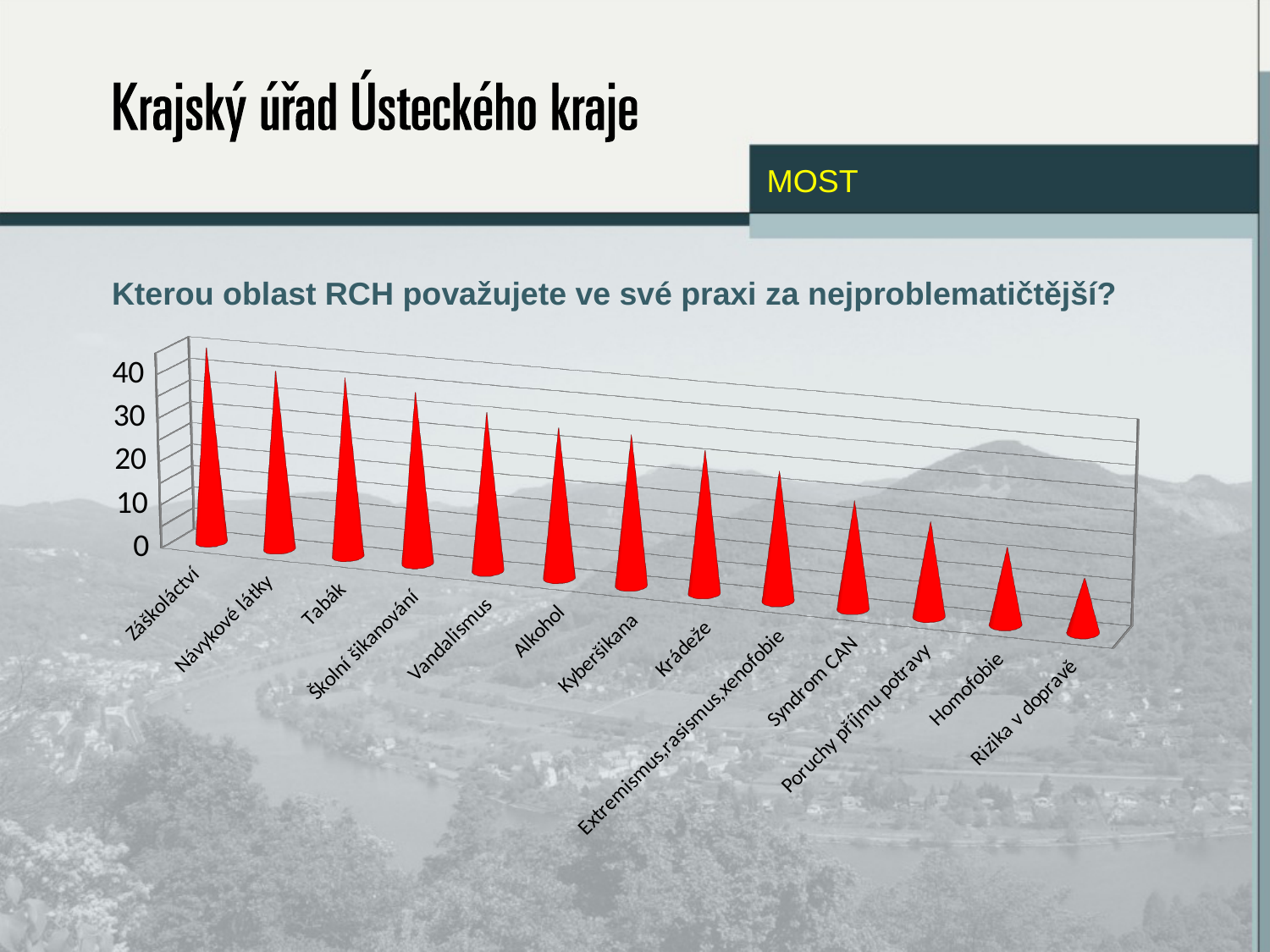
Which has a larger value, Tabák or Krádeže? Tabák Which has a larger value, Návykové látky or Syndrom CAN? Návykové látky What is the title of the chart? Kterou oblast RCH považujete ve své praxi za nejproblematičtější? Is the value for Homofobie greater or less than 30? less Do the values rise or fall from left to right along the x axis? fall Which has a larger value, Alkohol or Homofobie? Alkohol How many categories are shown on the x axis of the chart? 13 Which category has the lowest value in the chart? Rizika v dopravě Is the value for Rizika v dopravě greater or less than 20? less What kind of chart is shown on the slide? bar chart Which category has the highest value in the chart? Záškoláctví Is the value for Záškoláctví greater or less than 30? greater